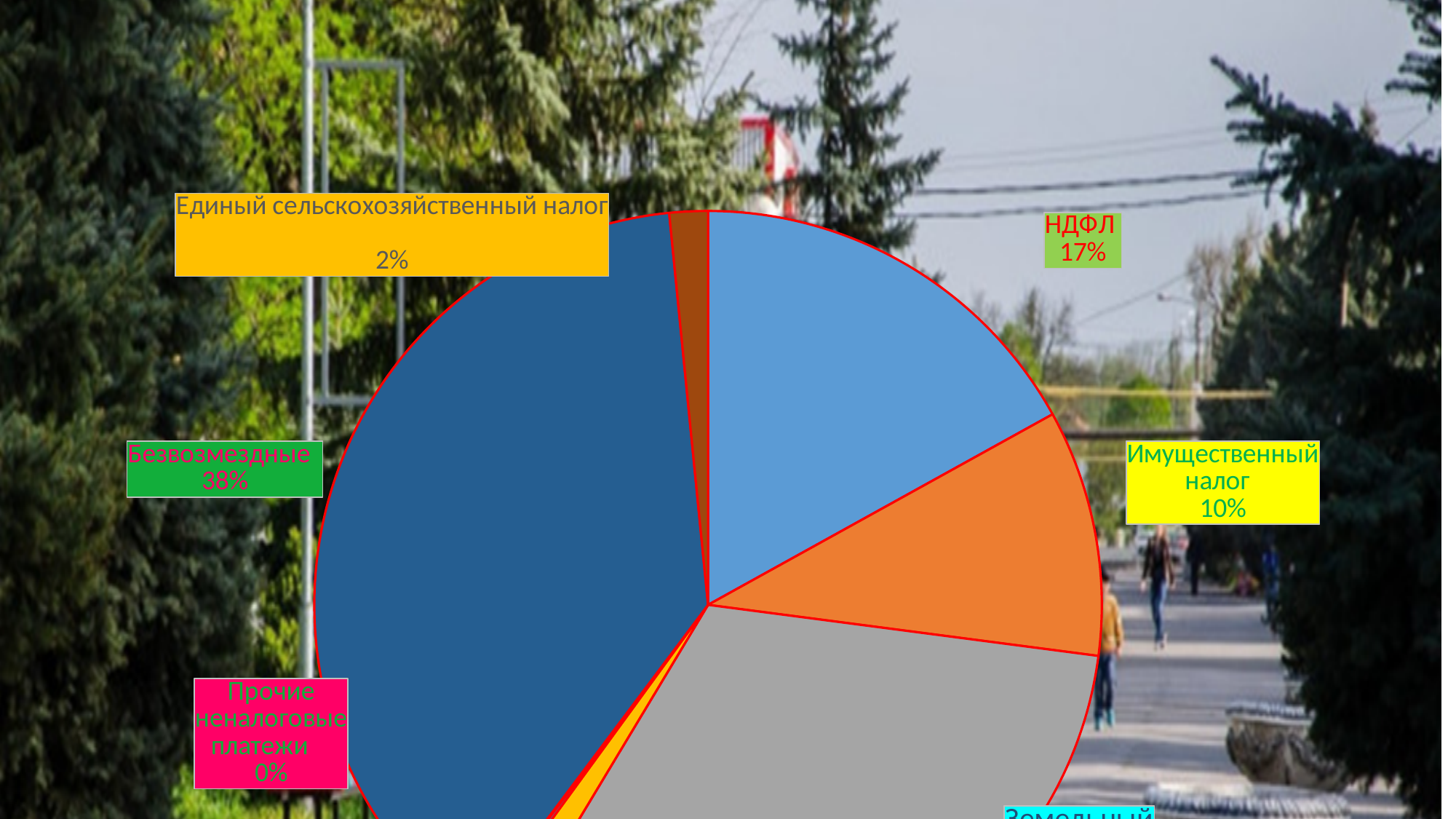
Which is larger, the share for НДФЛ or for Имущественный налог? НДФЛ Which labelled category has the smallest share of the pie? Прочие неналоговые платежи What is the difference between the shares of Безвозмездные and НДФЛ? 21% What percentage does the pie chart show for НДФЛ? 17% What value is given for Единый сельскохозяйственный налог? 2% Which labelled category has the largest share of the pie? Безвозмездные What percentage is shown for Безвозмездные? 38% What share of the pie is labelled Имущественный налог? 10% By how many percentage points does НДФЛ exceed Имущественный налог? 7% What percentage is shown for Прочие неналоговые платежи? 0% Which is larger, the share for Единый сельскохозяйственный налог or for Имущественный налог? Имущественный налог What type of chart is shown on the slide? Pie chart